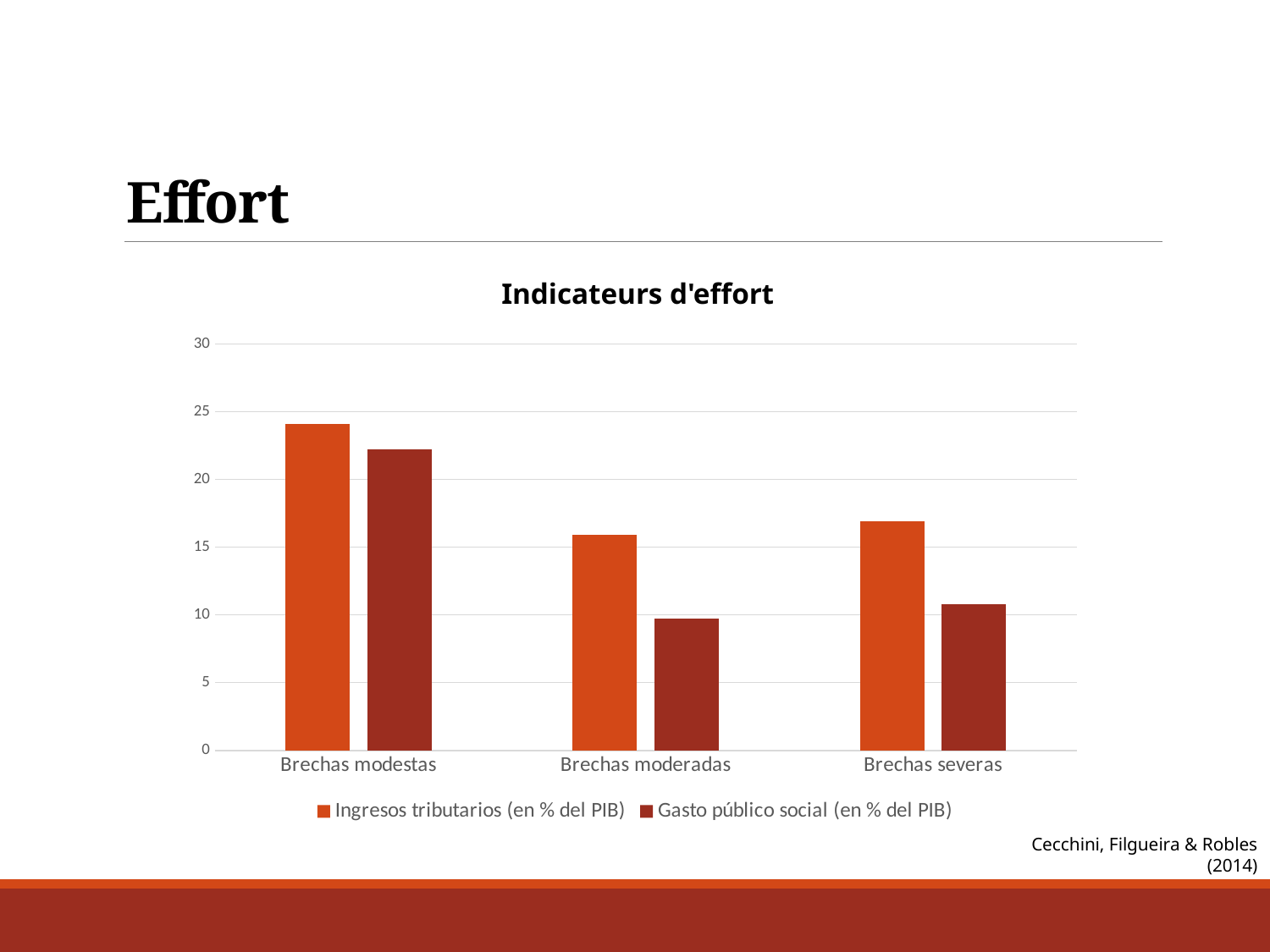
Is the value for Gasto público social (en % del PIB) in Brechas severas greater or less than 15? less Which category has the lowest value for Gasto público social (en % del PIB)? Brechas moderadas Which is larger: Gasto público social (en % del PIB) in Brechas modestas or in Brechas severas? Brechas modestas How many categories are shown on the x axis? 3 In Brechas severas, which is larger: Ingresos tributarios (en % del PIB) or Gasto público social (en % del PIB)? Ingresos tributarios (en % del PIB) What is the title of the chart? Indicateurs d'effort What type of chart is shown on the slide? bar chart Is the value for Ingresos tributarios (en % del PIB) in Brechas modestas greater or less than 20? greater Which category has the lowest value for Ingresos tributarios (en % del PIB)? Brechas moderadas How many series does the legend list? 2 Which category has the highest value for Ingresos tributarios (en % del PIB)? Brechas modestas